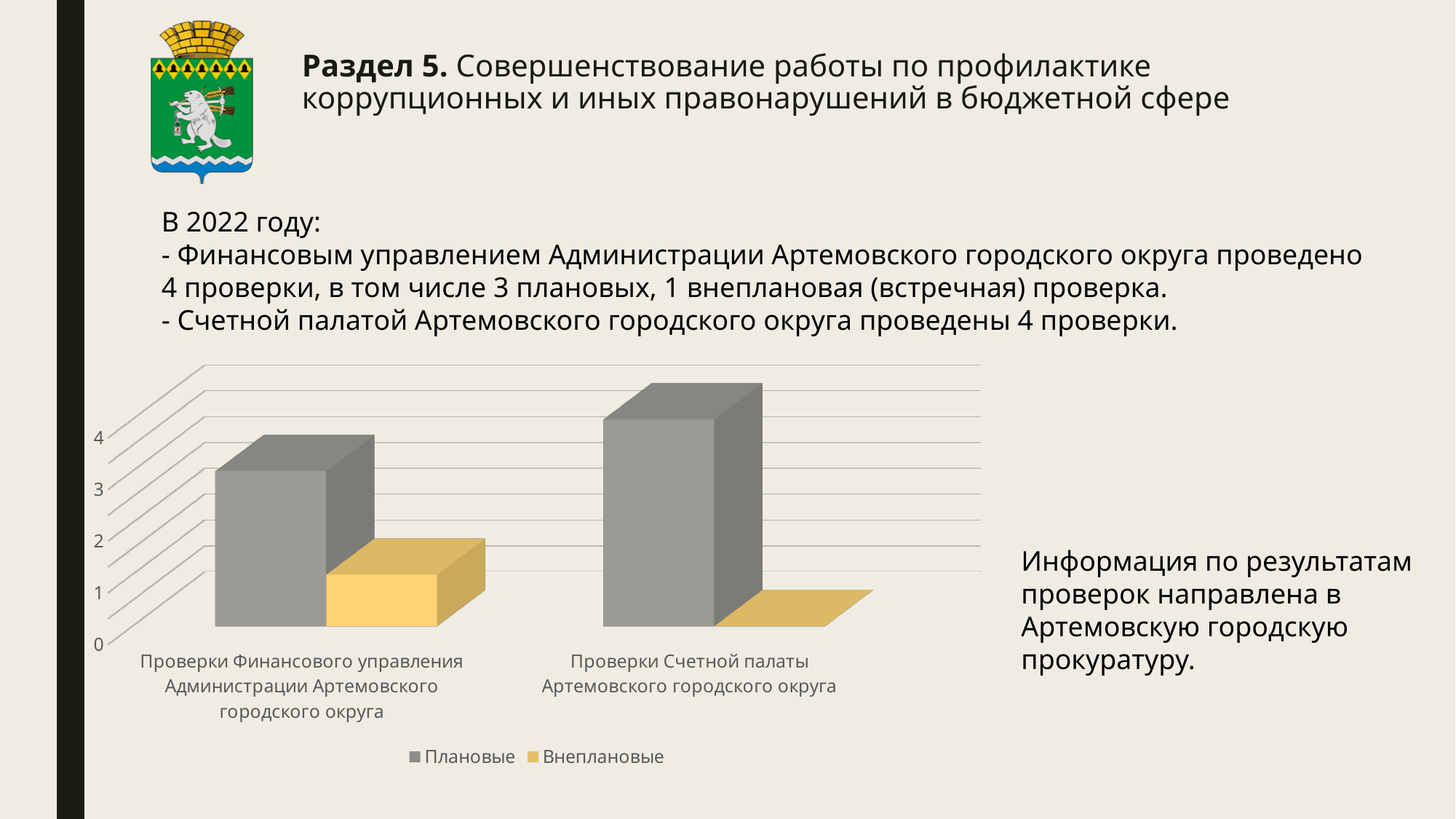
Which category has the lower Внеплановые value? Проверки Счетной палаты Артемовского городского округа Is the Плановые value for Проверки Счетной палаты Артемовского городского округа greater or less than 3? greater What kind of chart is shown on the slide? bar chart Is the Внеплановые value for Проверки Счетной палаты Артемовского городского округа greater or less than 1? less Is the Плановые value for Проверки Финансового управления Администрации Артемовского городского округа greater or less than 2? greater Which colour represents the Внеплановые series in the chart? yellow What are the two series named in the chart legend? Плановые, Внеплановые How many series does the chart legend list? 2 Which category has the higher Плановые value? Проверки Счетной палаты Артемовского городского округа For Проверки Финансового управления Администрации Артемовского городского округа, which is larger: the Плановые value or the Внеплановые value? Плановые How many categories are shown on the x axis of the chart? 2